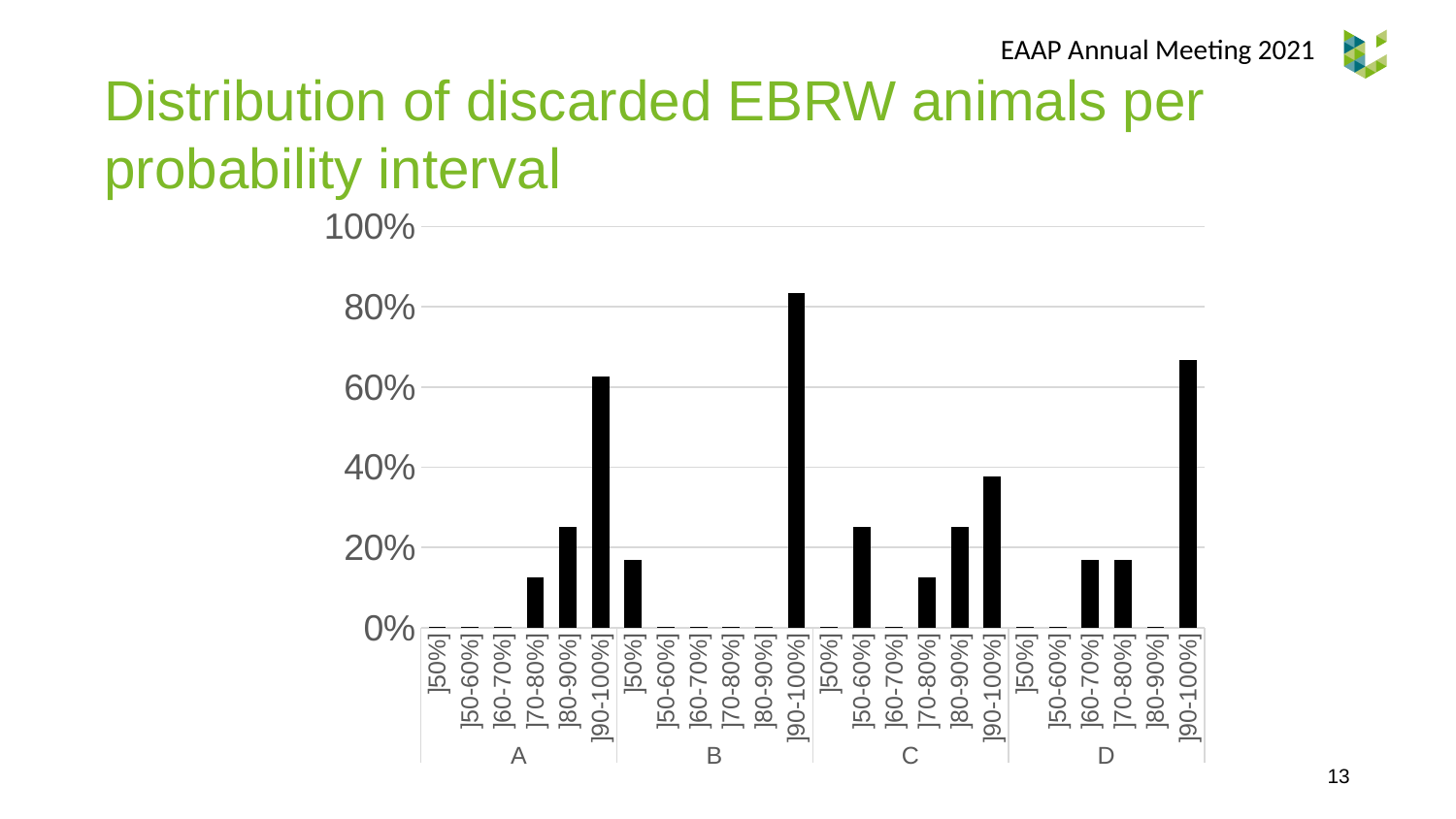
Is the value for the ]90-100%] interval in group A greater or less than 40%? greater Within group A, which probability interval has the highest bar? ]90-100%] How many groups (A, B, C, D) are shown along the x axis? 4 How many probability intervals are listed under each group on the x axis? 6 Which is larger: the ]90-100%] bar in group C or the ]90-100%] bar in group D? group D What kind of chart is shown on the slide? bar chart Is the value for the ]90-100%] interval in group B greater or less than 60%? greater Is the value for the ]50%] interval in group B greater or less than 40%? less What is the title of the chart on the slide? Distribution of discarded EBRW animals per probability interval Within group C, which probability interval has the highest bar? ]90-100%] Which group contains the tallest bar in the chart? B Which is larger in group A: the ]70-80%] bar or the ]80-90%] bar? ]80-90%]